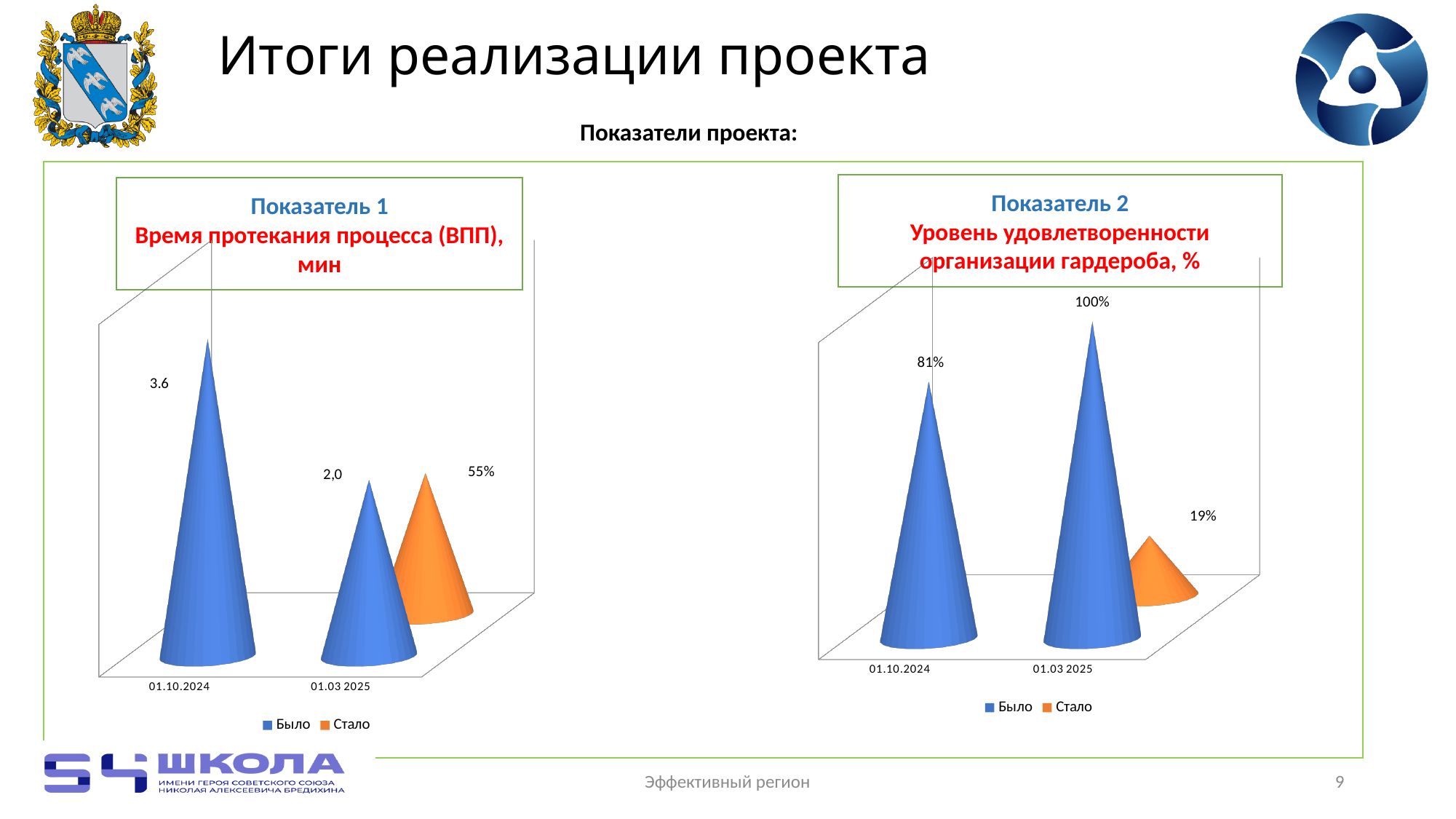
In the left chart (Показатель 1), which date has the lower Было value? 01.03 2025 In the right chart (Показатель 2), what is the value of the Было series for 01.10.2024? 81% In the left chart (Показатель 1), what is the value of the Было series for 01.03 2025? 2,0 In the left chart (Показатель 1), does the Было value rise or fall from 01.10.2024 to 01.03 2025? fall How many series does the legend of the left chart (Показатель 1) list? 2 In the right chart (Показатель 2), which date has the higher Было value? 01.03 2025 How many date categories are shown on the x axis of the right chart (Показатель 2)? 2 In the left chart (Показатель 1), what label is shown on the Стало series for 01.03 2025? 55% In the right chart (Показатель 2), what label is shown on the Стало series for 01.03 2025? 19% In the right chart (Показатель 2), what is the value of the Было series for 01.03 2025? 100% In the right chart (Показатель 2), what is the difference between the Было values for 01.03 2025 and 01.10.2024? 19% In the left chart (Показатель 1), what is the value of the Было series for 01.10.2024? 3.6